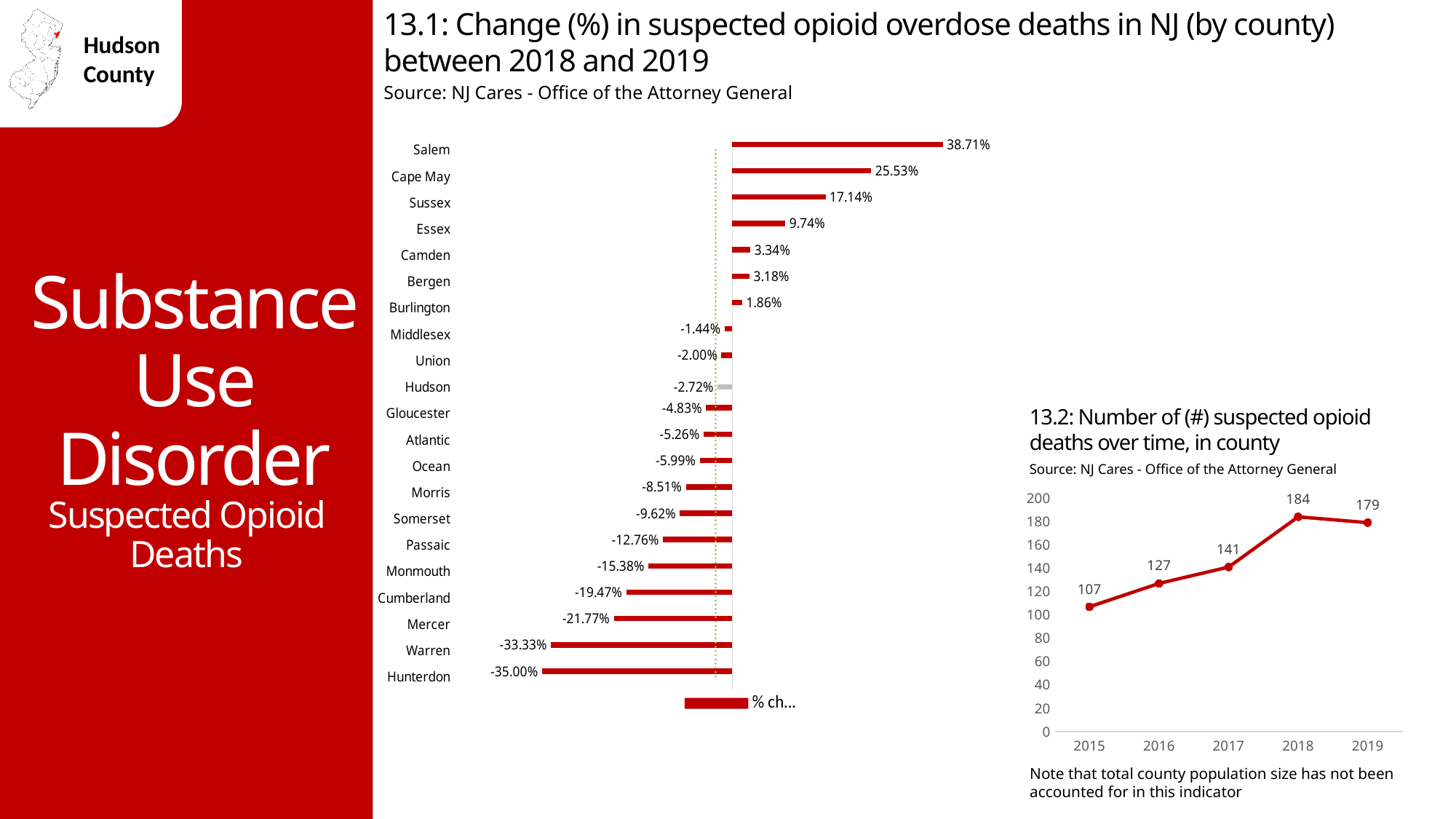
In chart 13.1, which county has the lowest change (%) in suspected opioid overdose deaths? Hunterdon In chart 13.2, which year has the highest number of suspected opioid deaths? 2018 In chart 13.2, what is the difference in suspected opioid deaths between 2018 and 2019? 5 In chart 13.1, which county has the highest change (%) in suspected opioid overdose deaths? Salem In chart 13.1, what is the change (%) in suspected opioid overdose deaths for Hudson County? -2.72% In chart 13.1, which has a larger change (%), Essex or Sussex? Sussex In chart 13.2, how many suspected opioid deaths were there in 2017? 141 What kind of chart is chart 13.2? Line chart What kind of chart is chart 13.1? Bar chart In chart 13.1, what is the change (%) for Cape May? 25.53% In chart 13.2, how many years are plotted? 5 In chart 13.1, how many counties are shown? 21